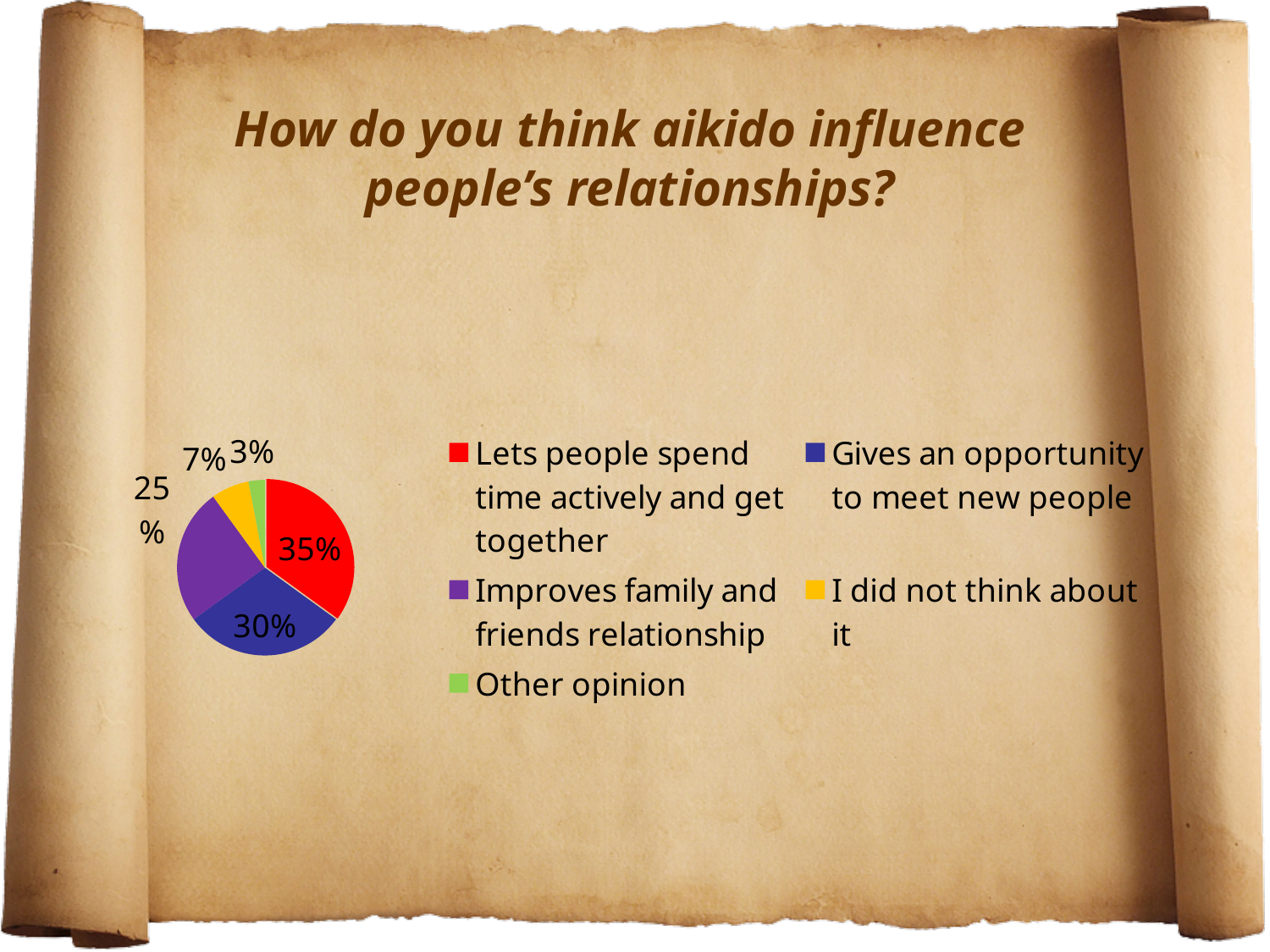
What share of the pie is 'I did not think about it'? 7% What share of the pie is 'Improves family and friends relationship'? 25% Which is larger: the share for 'Improves family and friends relationship' or the share for 'I did not think about it'? Improves family and friends relationship How many categories does the pie chart have? 5 What kind of chart is shown on the slide? pie chart What share of the pie is 'Gives an opportunity to meet new people'? 30% What is the difference between the shares for 'Lets people spend time actively and get together' and 'Gives an opportunity to meet new people'? 5% What colour is the slice for 'Other opinion'? green What share of the pie is 'Lets people spend time actively and get together'? 35% What share of the pie is 'Other opinion'? 3% Which category has the largest slice of the pie? Lets people spend time actively and get together Which category has the smallest slice of the pie? Other opinion